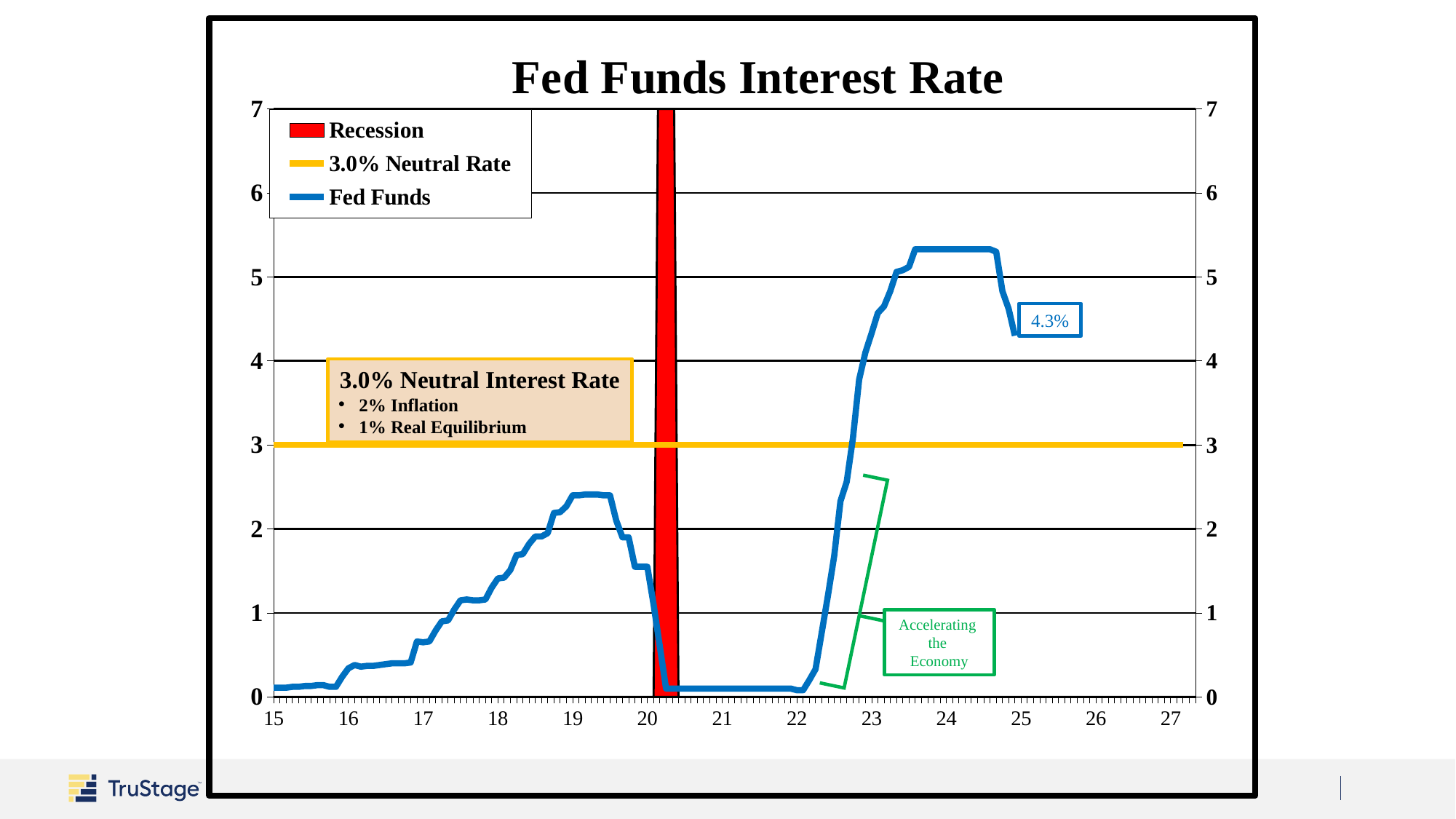
What is the value of the neutral rate line shown on the chart? 3.0% Does the Fed Funds rate rise or fall between 19.5 and 20.5 on the x axis? fall What colour is the Recession band on the chart? red Does the Fed Funds rate rise or fall between 22 and 23 on the x axis? rise What kind of chart is shown on the slide? line chart Is the Fed Funds rate in 2021 greater or less than 1? less Is the peak Fed Funds rate in 2019 greater or less than 3? less Which is higher: the Fed Funds peak in 2019 or the Fed Funds peak in 2024? 2024 What is the title of the chart? Fed Funds Interest Rate How many entries does the chart legend list? 3 Is the Fed Funds rate in 2024 greater or less than 5? greater What is the labelled value of the Fed Funds rate at the end of the blue line (around 25)? 4.3%